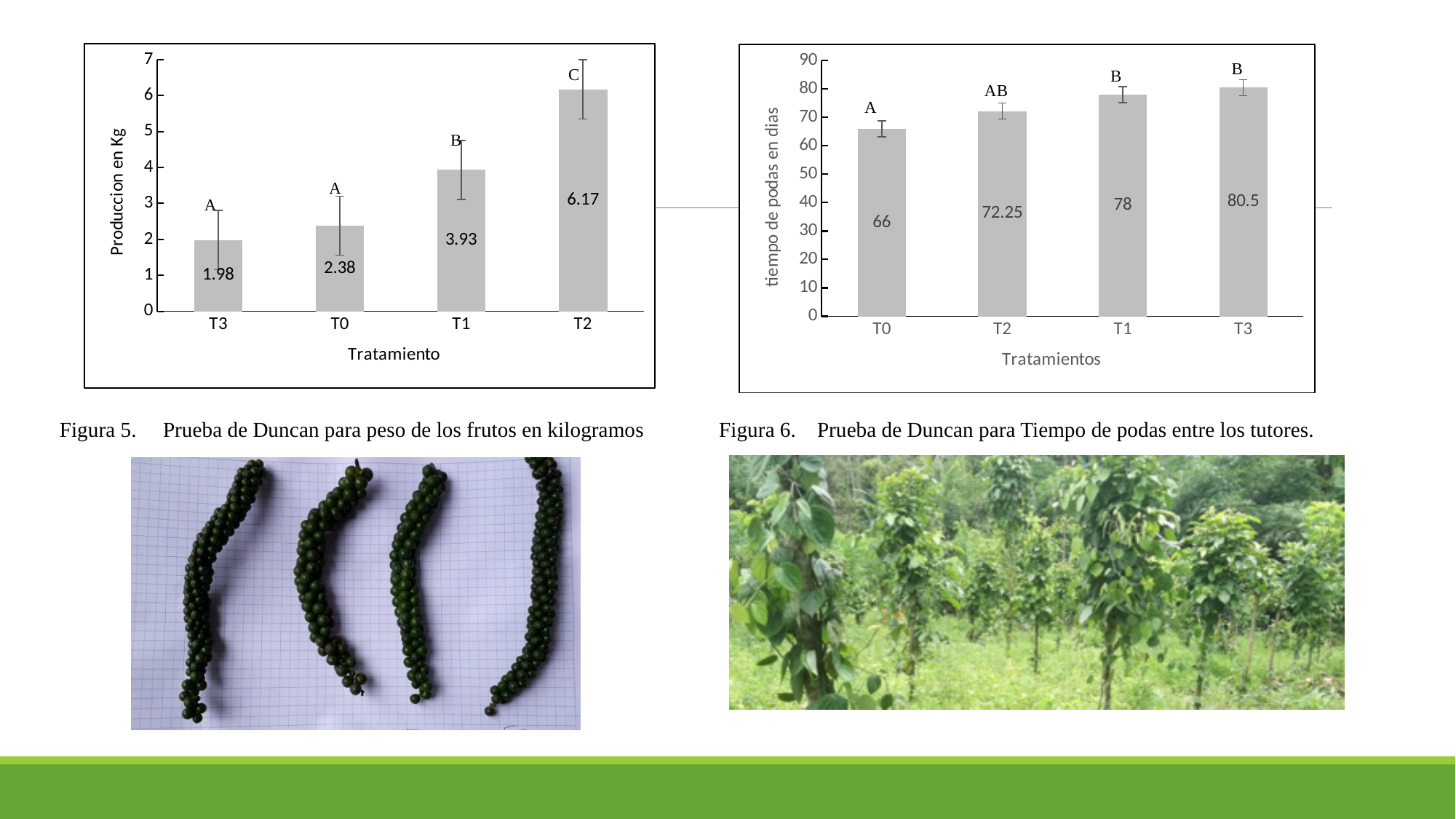
In the left chart (Figura 5), what is the difference between the values for T2 and T1? 2.24 In the right chart (Figura 6), is the value for T1 greater or less than 70? greater In the left chart (Figura 5), what is the value for T1? 3.93 In the left chart (Figura 5), how many treatments are plotted? 4 In the right chart (Figura 6), which treatment has the highest value? T3 In the left chart (Figura 5), which treatment has the lowest production? T3 What kind of chart is the right chart (Figura 6)? Bar chart In the left chart (Figura 5), what is the label on the y axis? Produccion en Kg In the right chart (Figura 6), what is the value for T2? 72.25 In the right chart (Figura 6), what is the difference between the values for T3 and T0? 14.5 In the left chart (Figura 5), which treatment has the highest production? T2 In the right chart (Figura 6), which treatment has the lowest value? T0